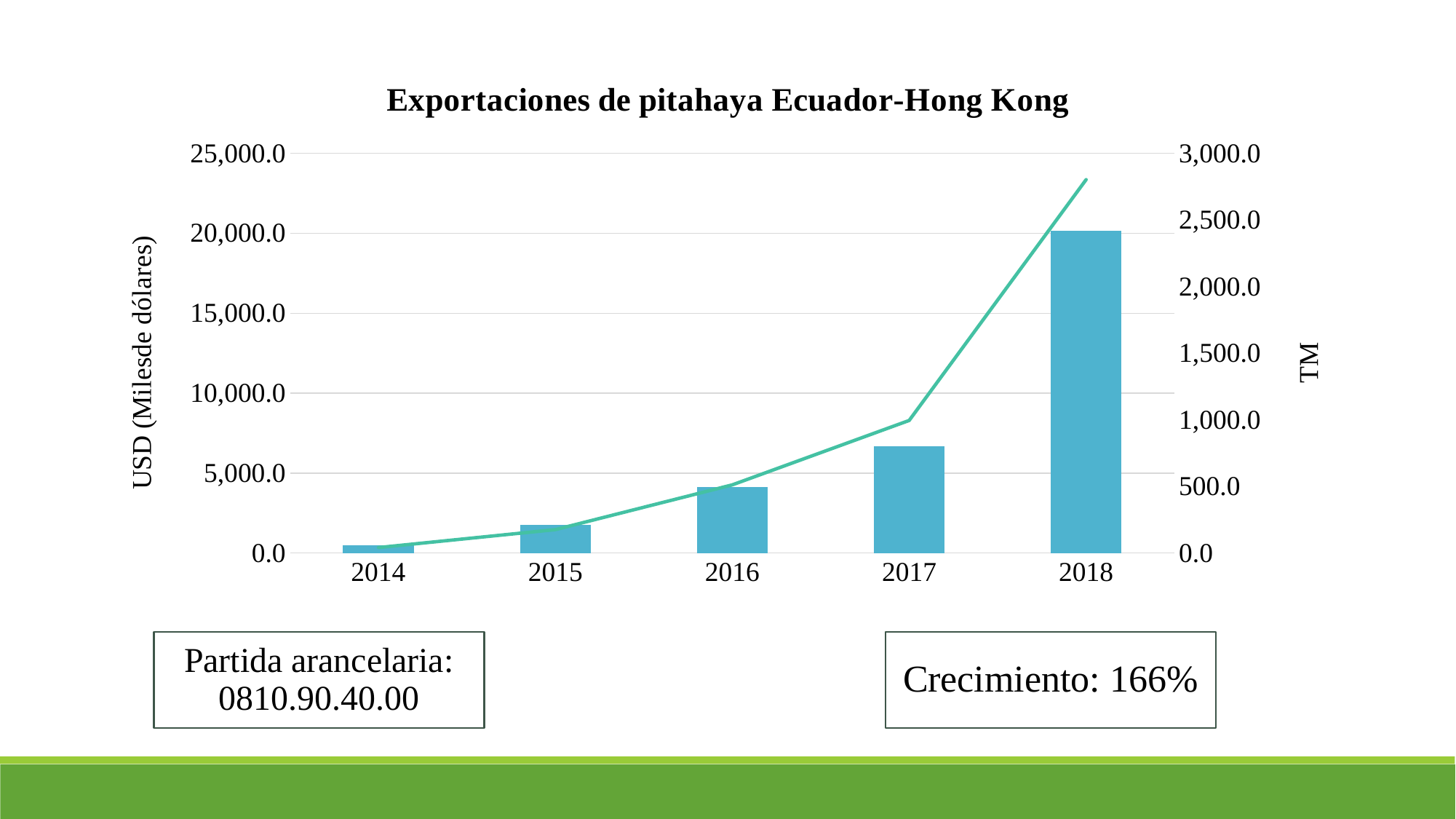
How many years are shown on the x axis of the chart? 5 What is the label of the right-hand vertical axis? TM Do the bar values rise or fall from 2014 to 2018? Rise Is the line value (TM) for 2016 greater or less than 1,000.0? less Is the bar value for 2017 greater or less than 10,000.0 (USD thousands)? less Which year has the larger bar value, 2016 or 2017? 2017 Which year has the lowest bar (USD exports)? 2014 What is the title of the chart? Exportaciones de pitahaya Ecuador-Hong Kong Is the line value (TM) for 2018 greater or less than 2,500.0? greater What kind of chart is shown on the slide? Combined bar and line chart Which year has the highest bar (USD exports)? 2018